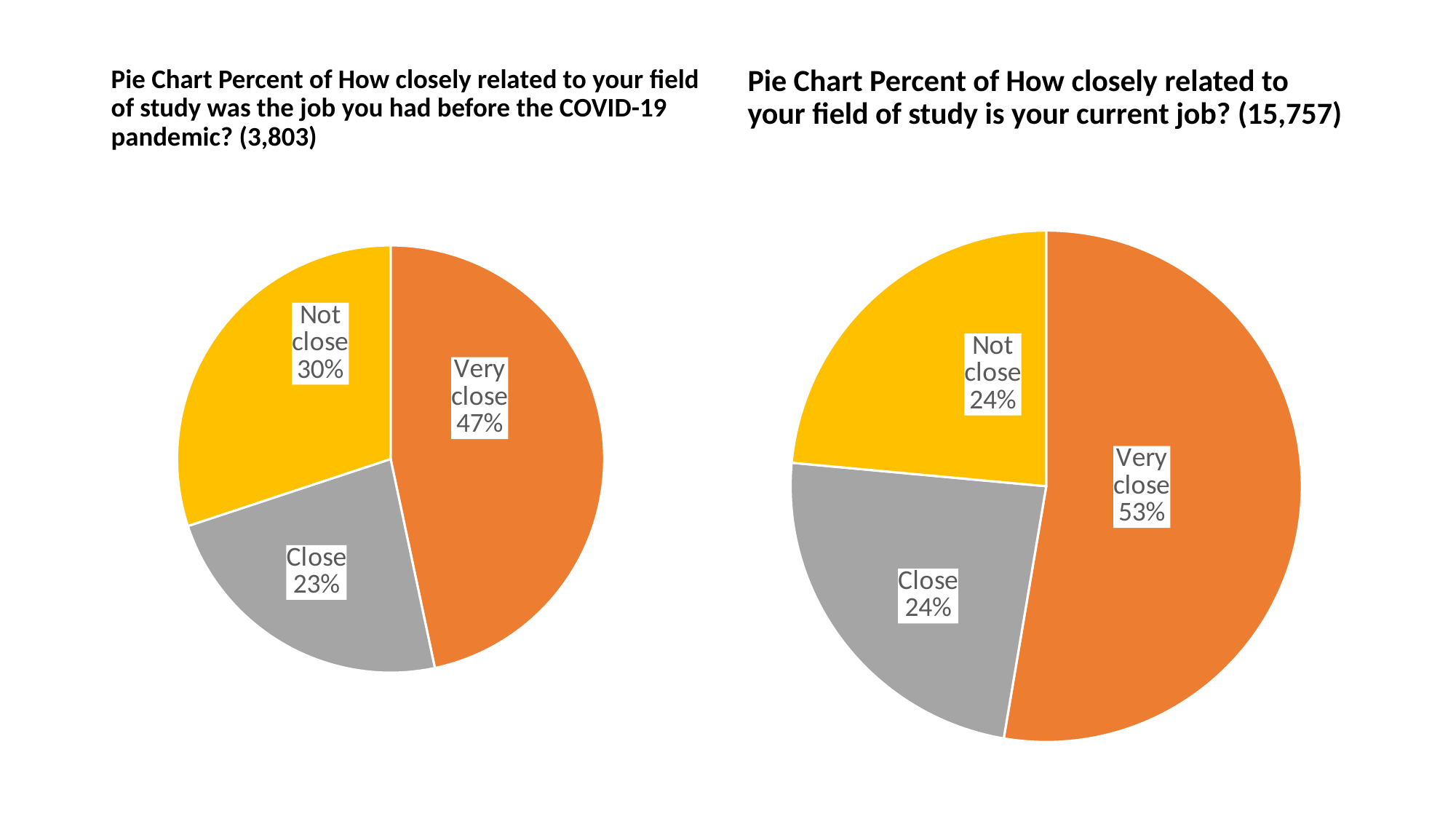
In the right pie chart (current job), what percentage is labelled 'Not close'? 24% In the left pie chart (job before the COVID-19 pandemic), what percentage is labelled 'Very close'? 47% In the left pie chart (job before the COVID-19 pandemic), what percentage is labelled 'Not close'? 30% In the left pie chart (job before the COVID-19 pandemic), which category has the largest share? Very close In the left pie chart (job before the COVID-19 pandemic), what percentage is labelled 'Close'? 23% What is the difference in percentage points between 'Very close' in the right pie chart (current job) and 'Very close' in the left pie chart (job before the pandemic)? 6 percentage points In the left pie chart (job before the COVID-19 pandemic), which is larger: 'Not close' or 'Close'? Not close In the right pie chart (current job), which category has the largest share? Very close What type of chart is used on this slide? Pie chart In the right pie chart (current job), what percentage is labelled 'Very close'? 53% In the left pie chart (job before the COVID-19 pandemic), which category has the smallest share? Close How many slices does the right pie chart (current job) have? 3